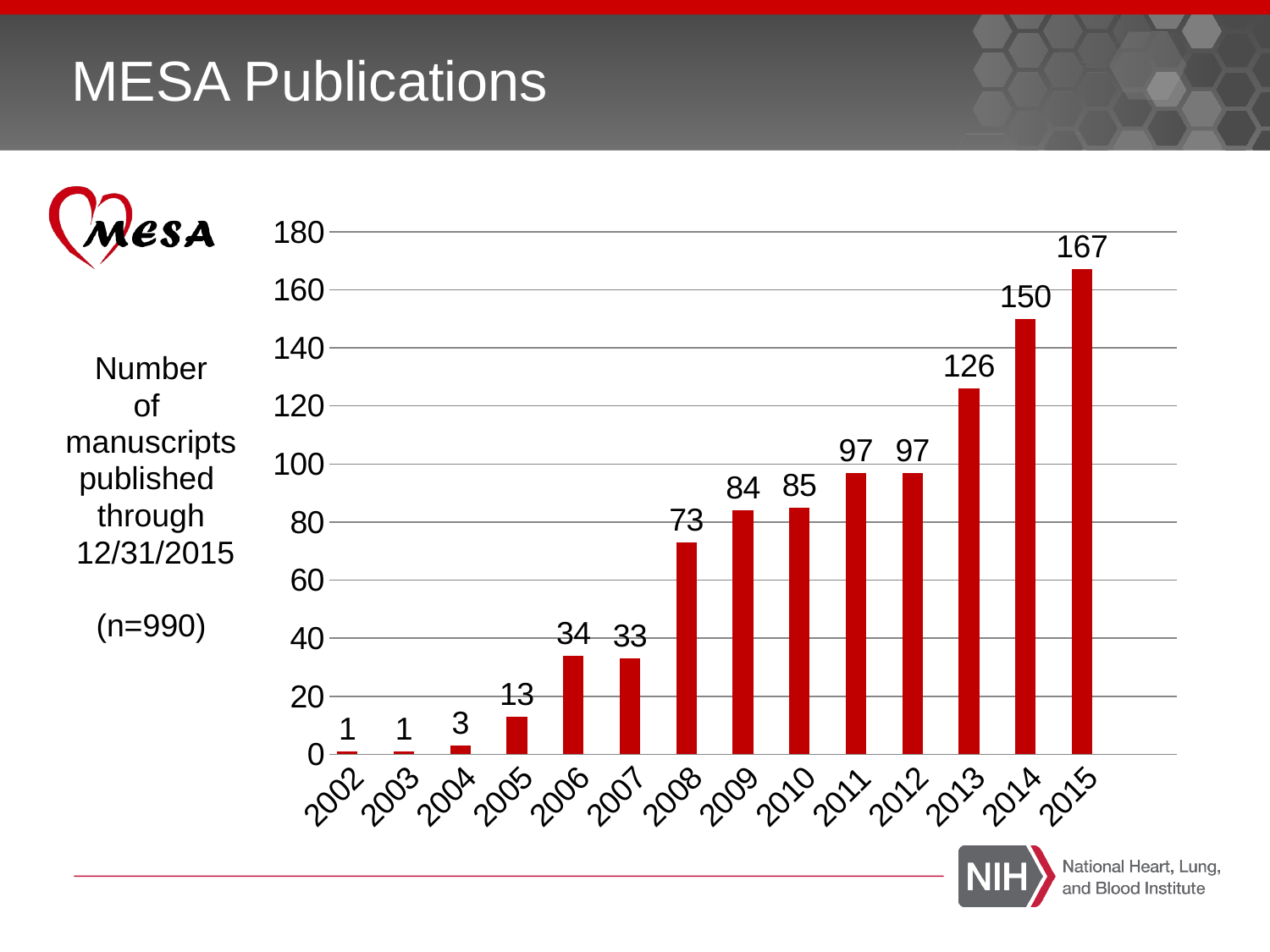
What is the value shown for 2005? 13 Which is larger, the value for 2009 or the value for 2010? 2010 What is the difference between the values for 2006 and 2007? 1 What is the difference between the values for 2015 and 2014? 17 How many years are shown on the x axis? 14 Do the values generally rise or fall from 2002 to 2015? Rise What is the title of the slide? MESA Publications What total number of manuscripts (n) is stated on the slide? 990 What kind of chart is shown on the slide? Bar chart How many manuscripts were published in 2013? 126 What is the value shown for 2008? 73 Which year has the highest number of manuscripts published? 2015